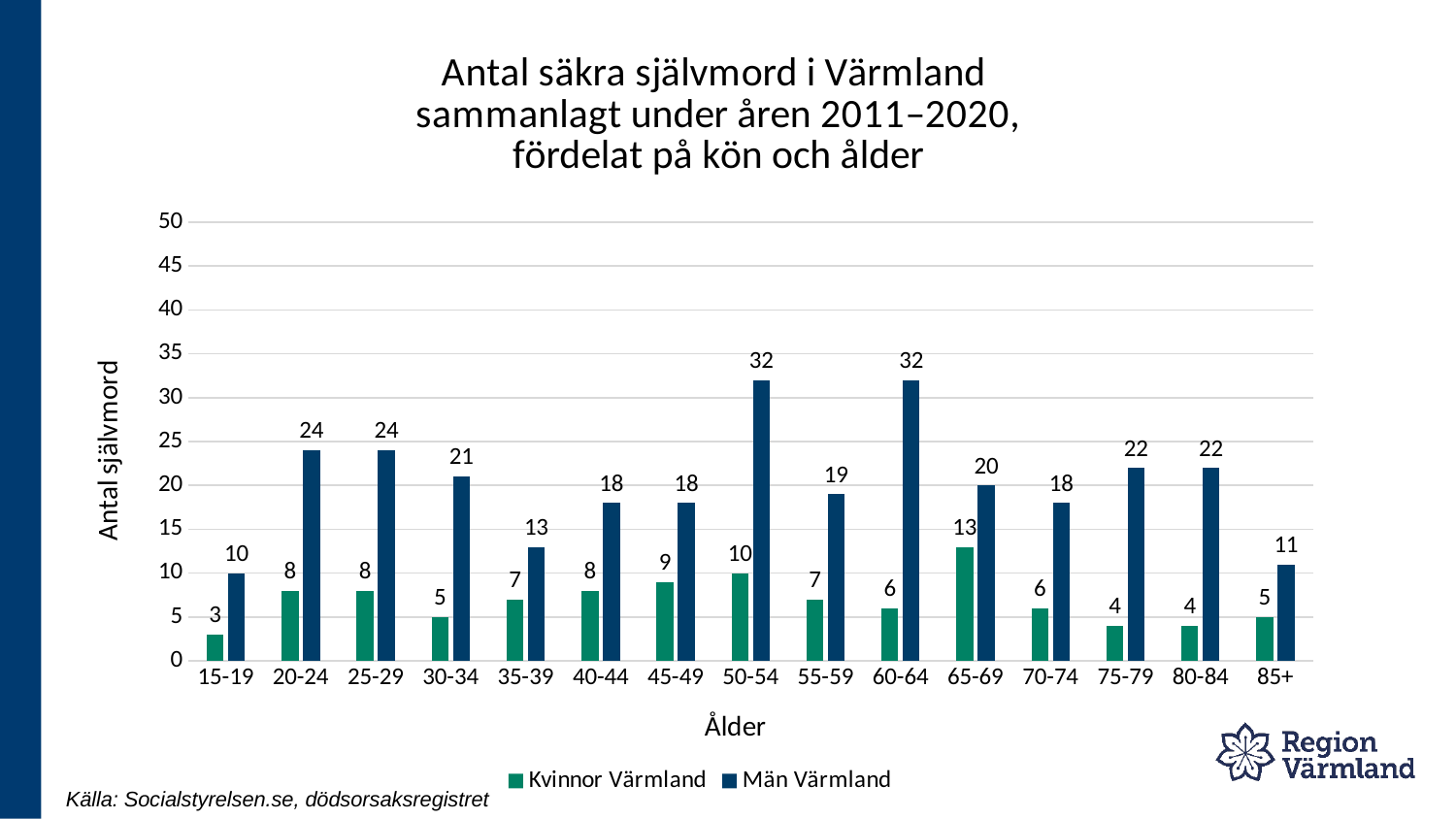
How many age groups are shown on the x axis? 15 What is the label of the y axis? Antal självmord How many series does the legend list? 2 What type of chart is shown on the slide? Bar chart Which age group has the highest value for Kvinnor Värmland? 65-69 Which age group has the lowest value for Kvinnor Värmland? 15-19 What is the value for Män Värmland in the 50-54 age group? 32 Which is larger in the 30-34 age group: Kvinnor Värmland or Män Värmland? Män Värmland What is the total of Kvinnor Värmland and Män Värmland in the 85+ age group? 16 Which age group has the lowest value for Män Värmland? 15-19 What is the value for Kvinnor Värmland in the 65-69 age group? 13 What is the difference between Män Värmland and Kvinnor Värmland in the 60-64 age group? 26